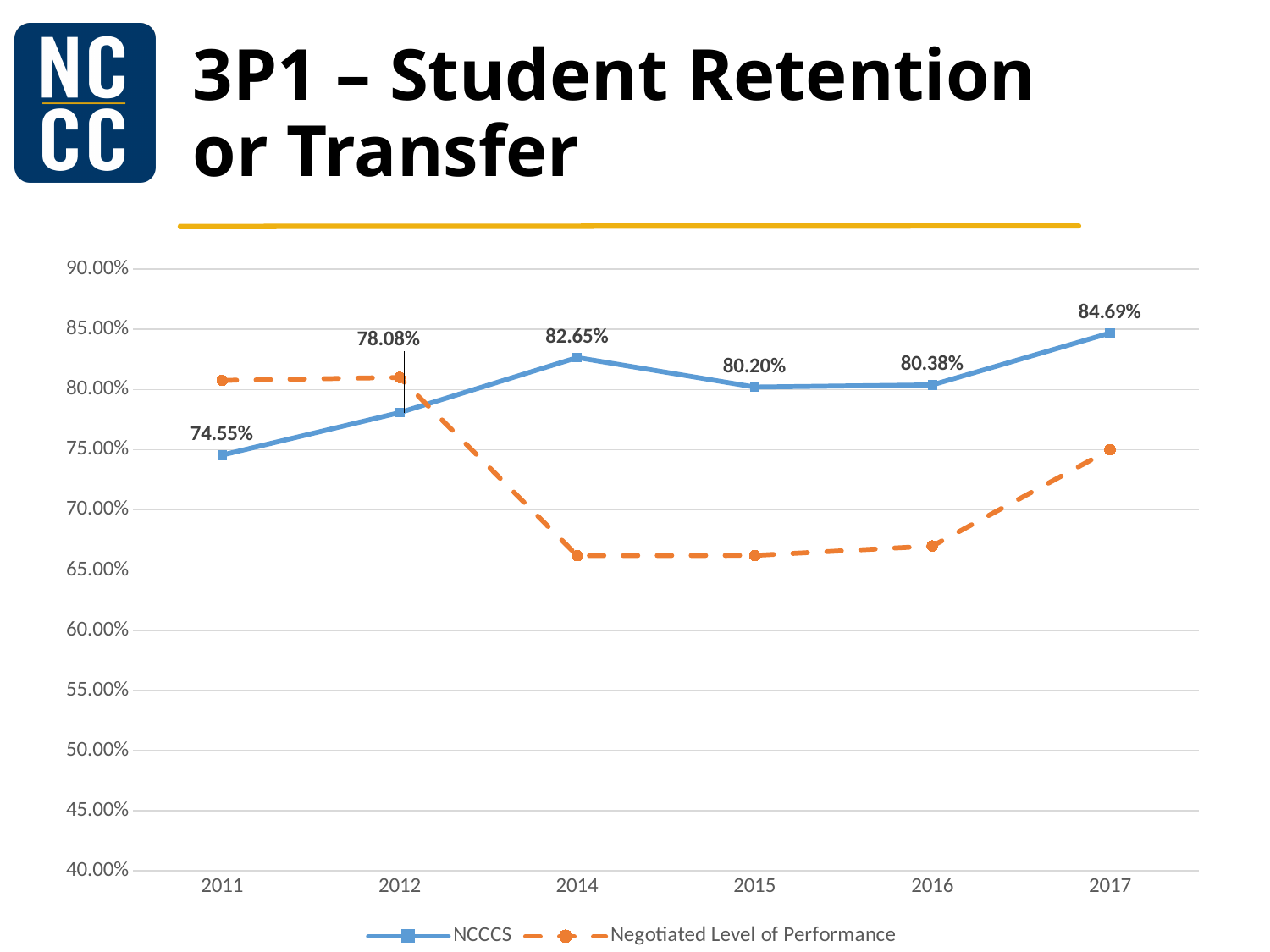
What is the NCCCS value for 2014? 82.65% What kind of chart is shown on the slide? line chart How many series does the legend list? 2 What is the NCCCS value for 2011? 74.55% Is the Negotiated Level of Performance value for 2014 greater or less than 70.00%? less In which year is the NCCCS value lowest? 2011 Which is larger, the NCCCS value for 2015 or for 2016? 2016 Is the Negotiated Level of Performance value for 2011 greater or less than 80.00%? greater In which year is the NCCCS value highest? 2017 What is the NCCCS value for 2017? 84.69% How many years are shown on the x axis? 6 What is the difference between the NCCCS values for 2017 and 2011? 10.14%